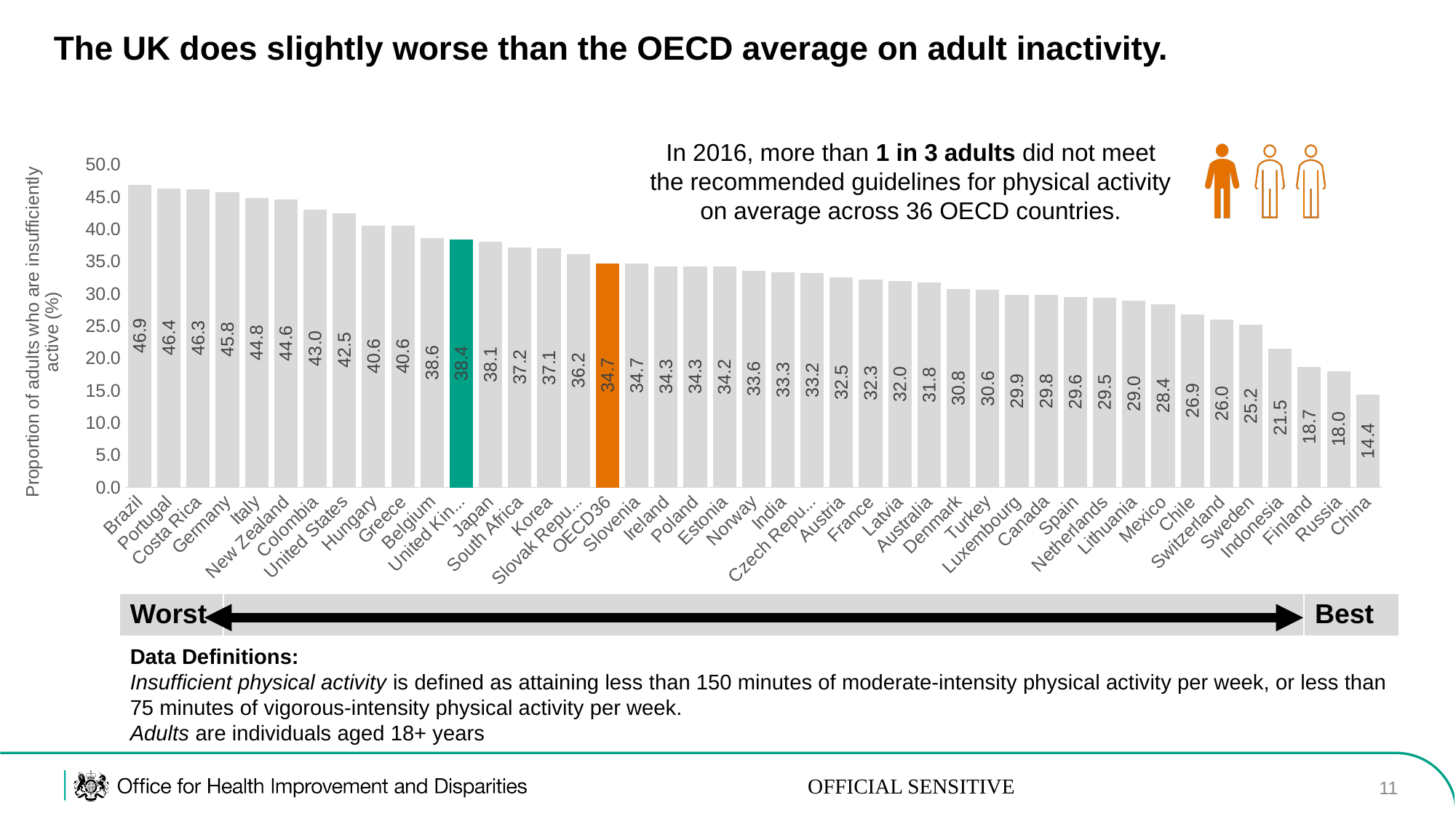
What kind of chart is shown on the slide? Bar chart Do the values rise or fall moving from left to right along the x axis? Fall What is the value for Japan? 38.1 Which country has the highest proportion of insufficiently active adults? Brazil Which country has the lowest proportion of insufficiently active adults? China How many bars are plotted in the chart? 43 What is the value for the United Kingdom? 38.4 What is the value for OECD36? 34.7 How much higher is the United Kingdom's value than the OECD36 value? 3.7 What is the value for Mexico? 28.4 Which has a higher value, Germany or Italy? Germany What is the difference between the values for Brazil and China? 32.5